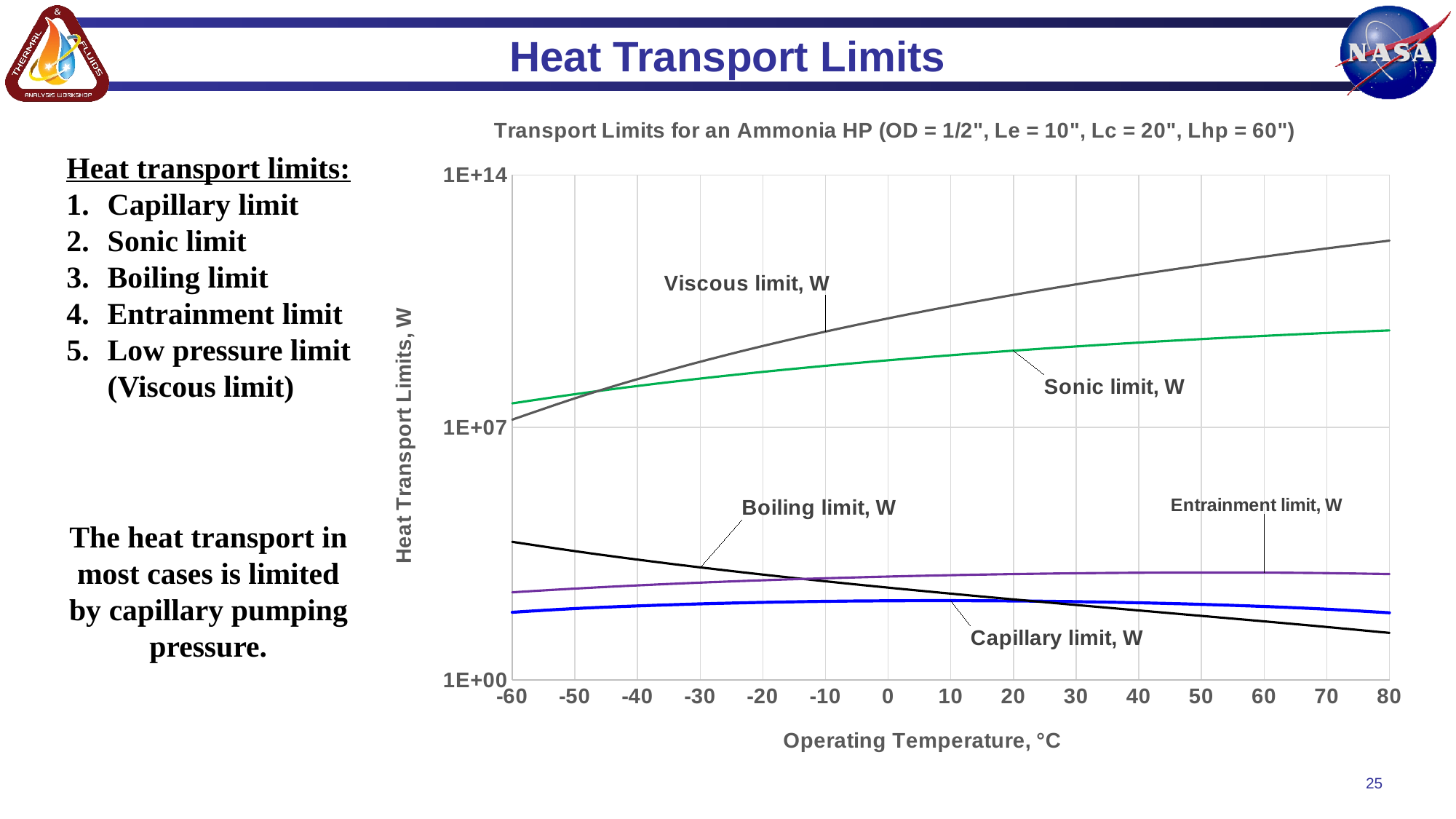
Is the value of the Viscous limit at 80 °C greater or less than 1E+07? greater What is the label of the x axis of the chart? Operating Temperature, °C How many limit curves are plotted on the chart? 5 Which limit curve is highest at an operating temperature of 80 °C? Viscous limit, W What kind of chart is shown on the slide? Line chart Does the Viscous limit curve rise or fall as operating temperature increases? Rises At an operating temperature of -60 °C, which is larger: the Sonic limit or the Viscous limit? Sonic limit What is the title of the chart? Transport Limits for an Ammonia HP (OD = 1/2", Le = 10", Lc = 20", Lhp = 60") Is the value of the Capillary limit at 0 °C greater or less than 1E+07? less How many tick labels are shown on the x axis of the chart? 15 Does the Boiling limit curve rise or fall as operating temperature increases? Falls Which limit curve is lowest at an operating temperature of 80 °C? Boiling limit, W